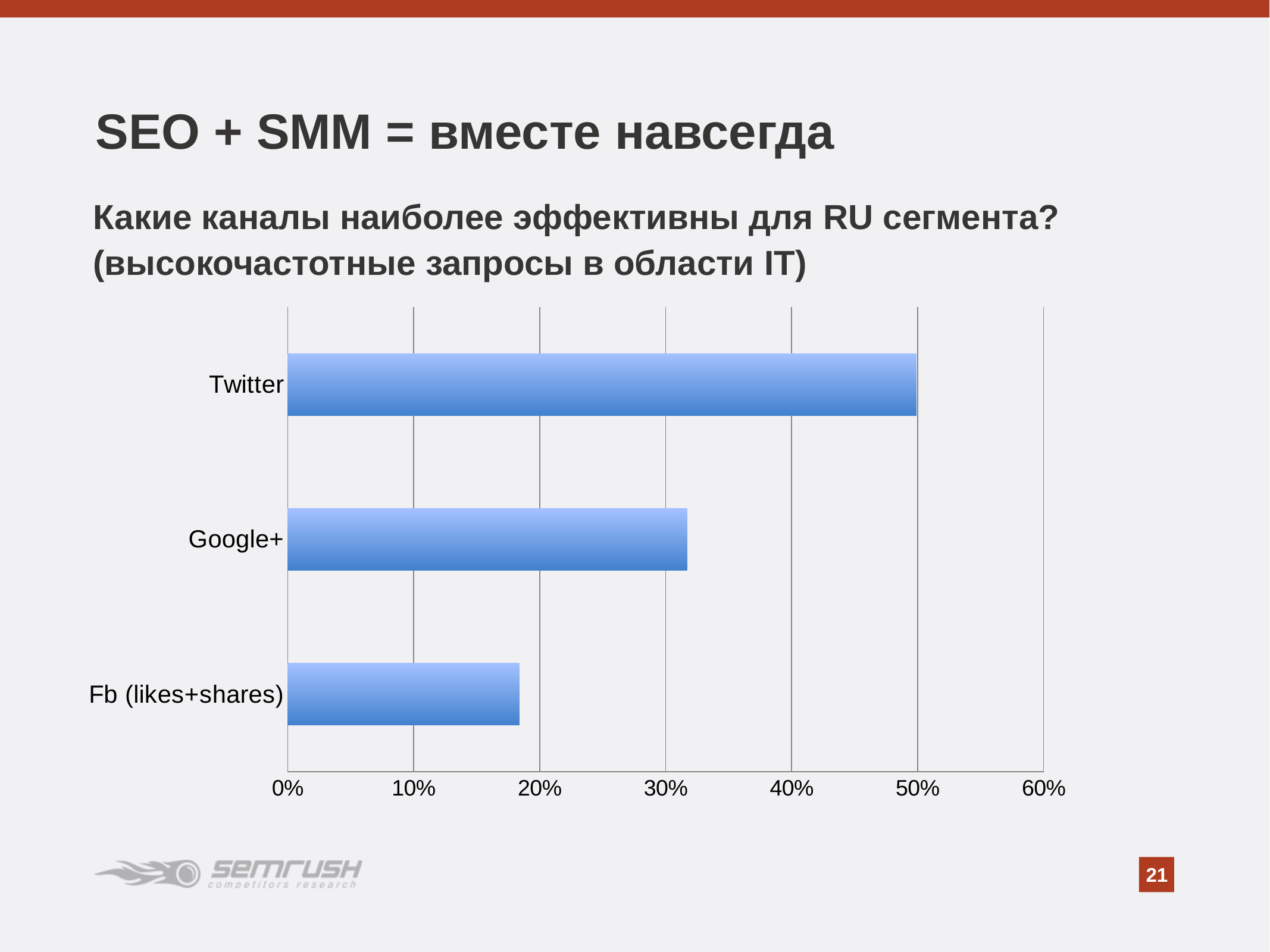
Is the value for Google+ greater or less than 40%? less Which category has the lowest value in the chart? Fb (likes+shares) Which is larger, the value for Google+ or the value for Fb (likes+shares)? Google+ Which is larger, the value for Twitter or the value for Google+? Twitter Is the value for Google+ greater or less than 30%? greater Which category has the highest value in the chart? Twitter How many categories are plotted in the chart? 3 What kind of chart is shown on the slide? bar chart Is the value for Fb (likes+shares) greater or less than 10%? greater What is the maximum value shown on the chart's horizontal axis? 60%